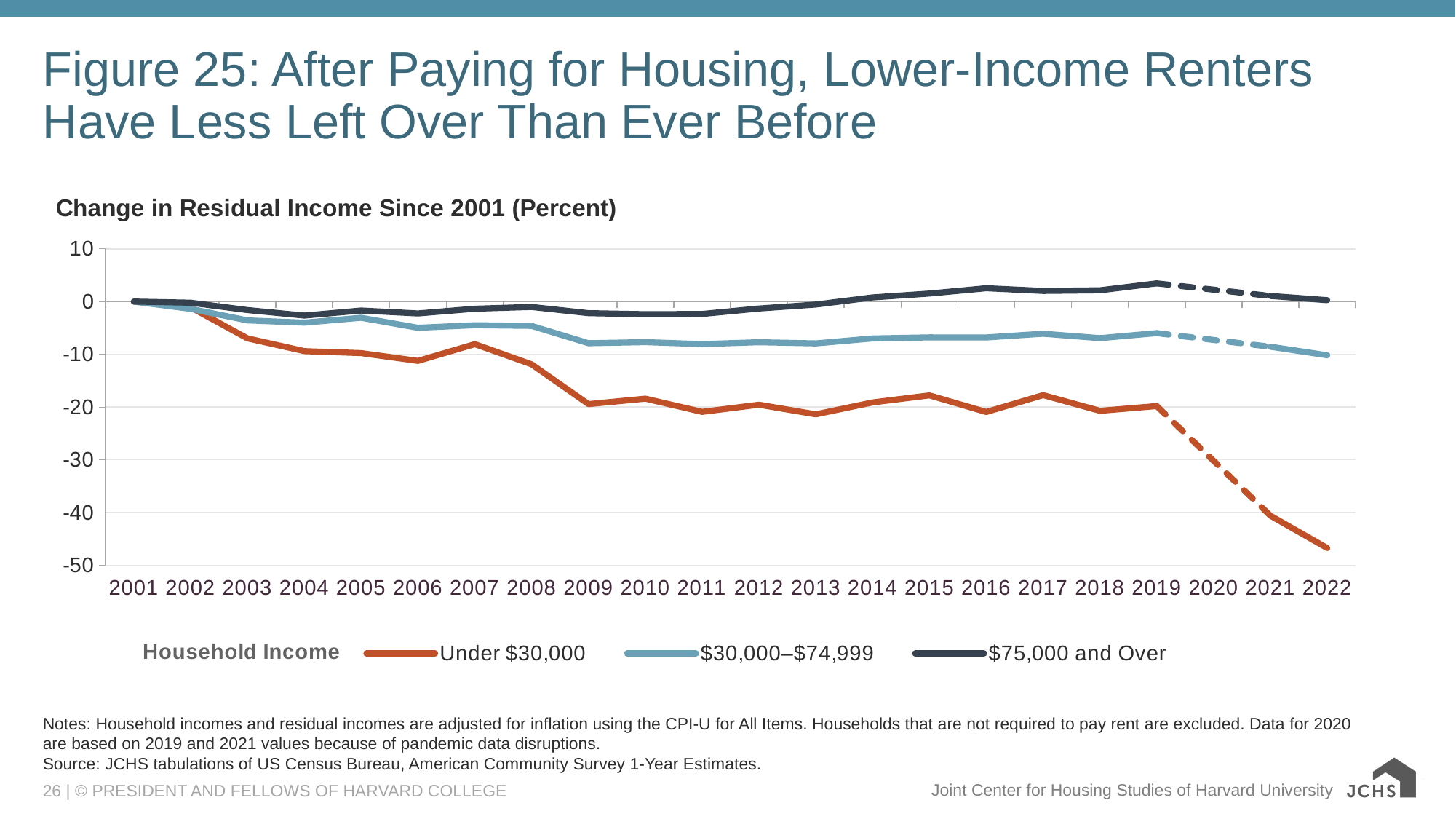
Is the value for Under $30,000 in 2009 greater or less than -10? less What kind of chart is shown on the slide? Line chart Which household income group has the highest value in 2022? $75,000 and Over How many series does the legend list? 3 Does the Under $30,000 line rise or fall overall from 2001 to 2022? Fall Which household income group has the lowest value in 2022? Under $30,000 Is the value for $75,000 and Over in 2019 greater or less than 0? greater Is the value for Under $30,000 in 2022 greater or less than -40? less For Under $30,000, which is larger: the value in 2019 or the value in 2022? 2019 How many years are shown along the x axis? 22 What is the title of the chart's y-axis measure shown above the plot? Change in Residual Income Since 2001 (Percent)